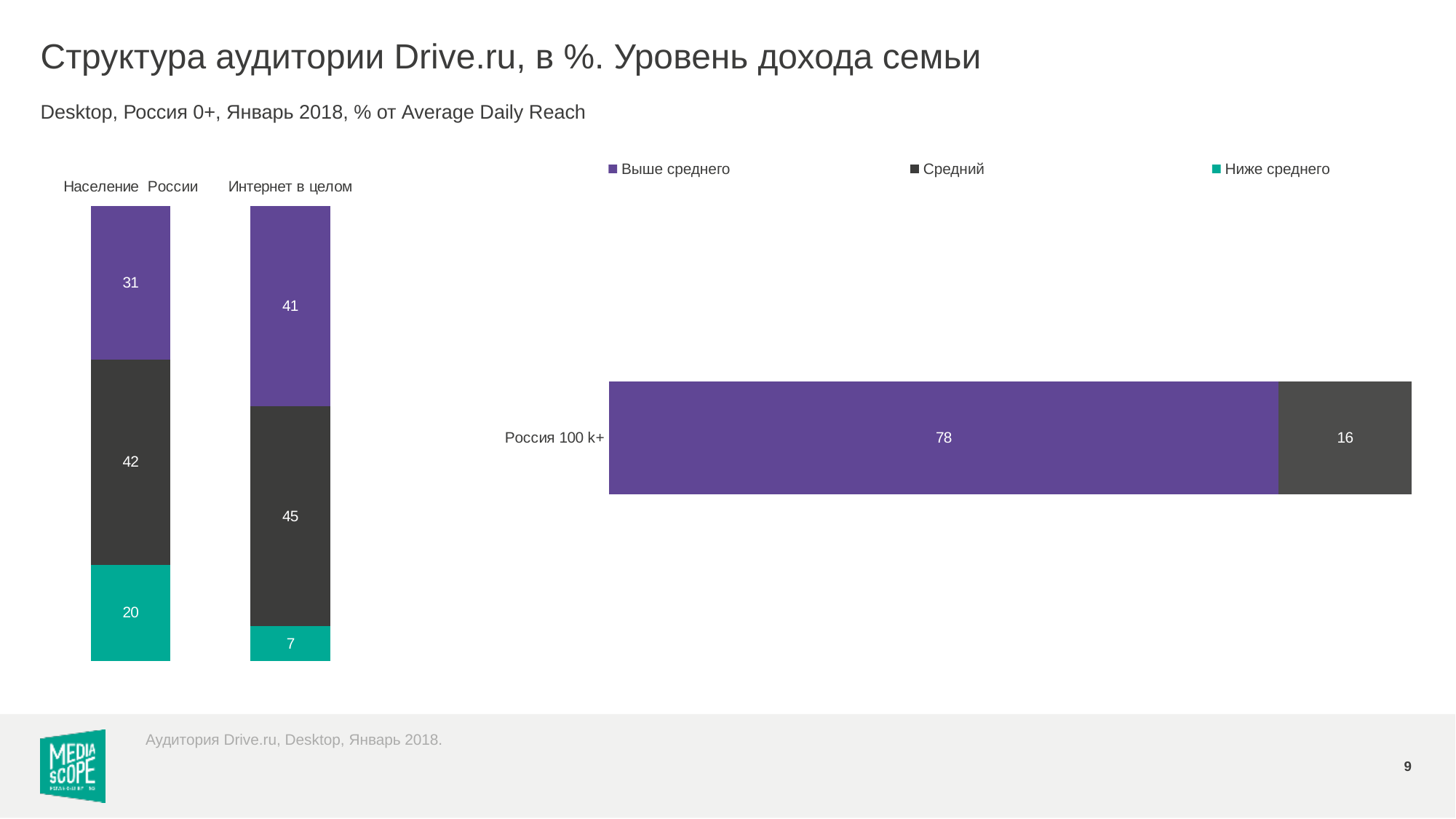
On the right chart, what is the difference between the Выше среднего and Средний values for Россия 100 k+? 62 On the left chart, which is larger: Выше среднего for Население России or Выше среднего for Интернет в целом? Интернет в целом On the left chart, which segment is the smallest for Интернет в целом? Ниже среднего On the left chart, what is the value for Выше среднего for Население России? 31 On the right chart, what is the value for Выше среднего for Россия 100 k+? 78 On the left chart, what is the value for Средний for Интернет в целом? 45 On the left chart, which segment is the largest for Население России? Средний How many series does the legend list? 3 On the left chart, what is the difference between the Ниже среднего values for Население России and Интернет в целом? 13 On the right chart, what is the value for Средний for Россия 100 k+? 16 On the left chart, what is the value for Ниже среднего for Интернет в целом? 7 What kind of chart is the right chart? Stacked bar chart